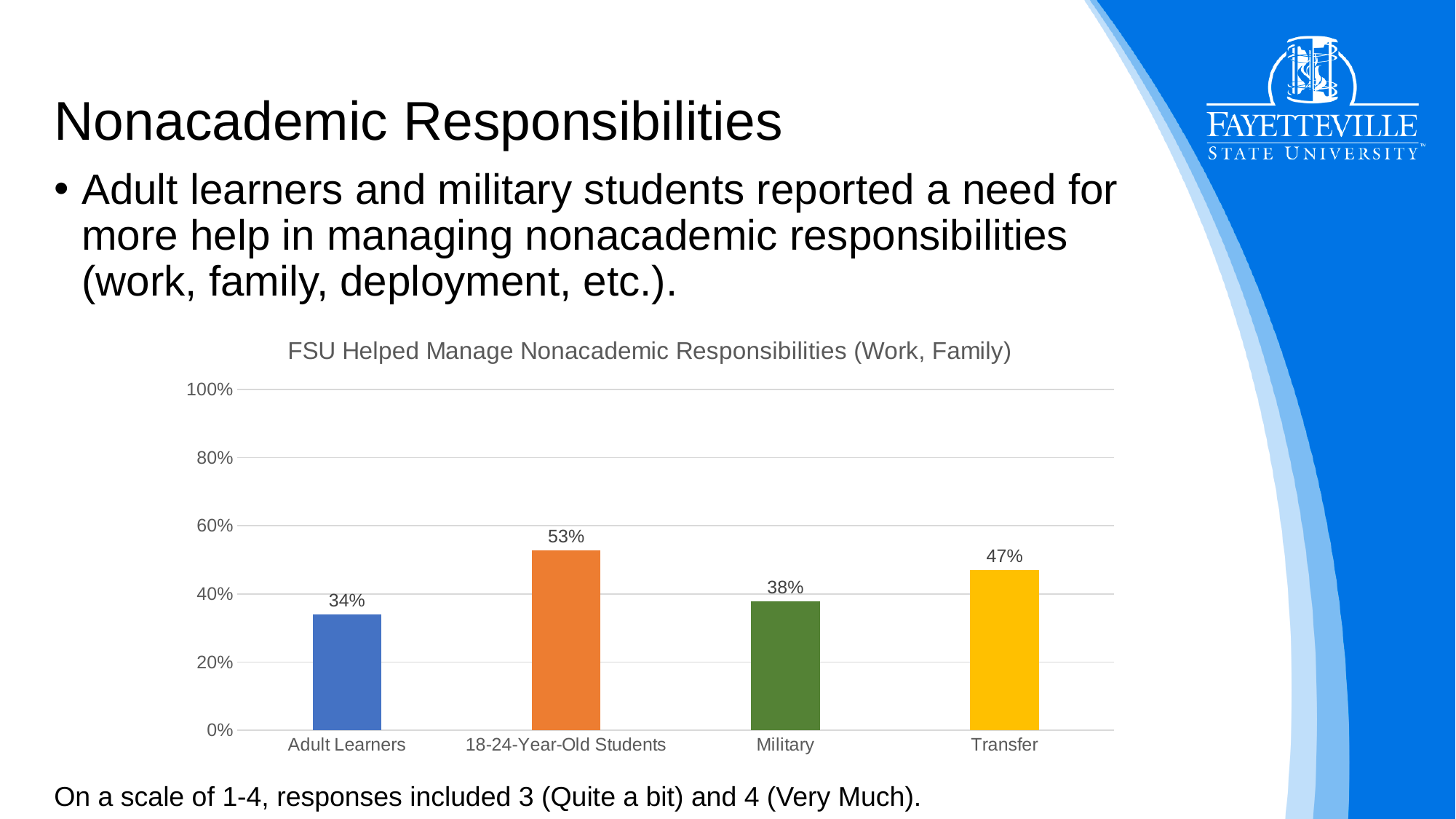
What is the difference between the values for 18-24-Year-Old Students and Adult Learners? 19% Is the value for Military greater or less than 40%? less What kind of chart is shown on the slide? bar chart What is the title of the chart? FSU Helped Manage Nonacademic Responsibilities (Work, Family) What is the value for Adult Learners? 34% How many categories are shown on the x axis? 4 Which category has the highest value? 18-24-Year-Old Students What is the value for 18-24-Year-Old Students? 53% What is the value for Military? 38% What is the value for Transfer? 47% Which is larger, the value for Transfer or the value for Military? Transfer Which category has the lowest value? Adult Learners